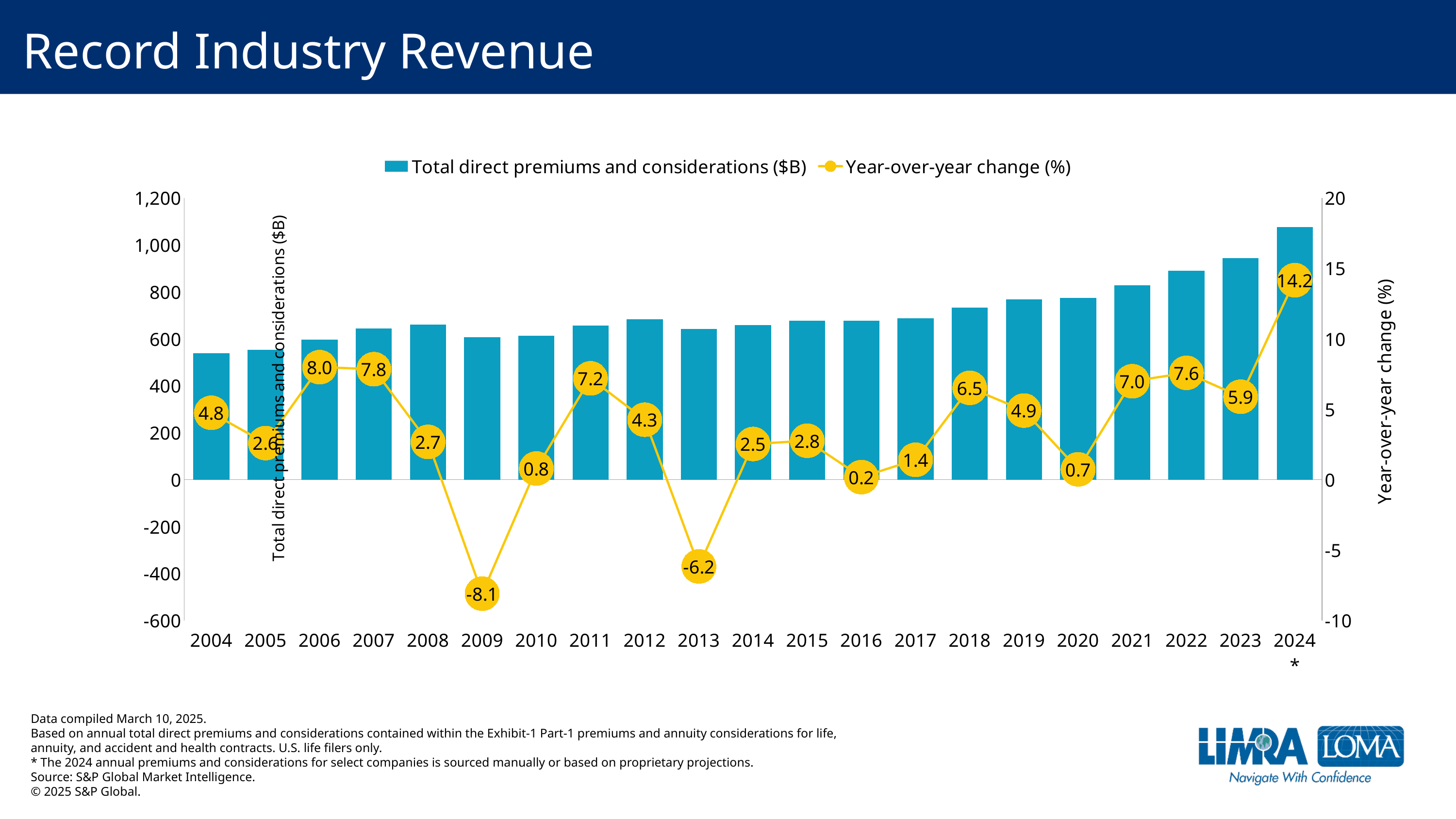
What is the difference between the year-over-year change (%) for 2024* and 2023? 8.3 What is the year-over-year change (%) shown for 2024*? 14.2 Which year has the lowest year-over-year change (%)? 2009 How many series does the legend list? 2 What is the year-over-year change (%) shown for 2009? -8.1 Is the value of total direct premiums and considerations ($B) for 2004 greater or less than 600? less What is the year-over-year change (%) shown for 2013? -6.2 Is the value of total direct premiums and considerations ($B) for 2024* greater or less than 1,000? greater Which year has the larger year-over-year change (%), 2018 or 2019? 2018 What kind of chart is shown on the slide? Combination bar and line chart How many years are shown on the x axis of the chart? 21 Which year has the highest year-over-year change (%)? 2024*